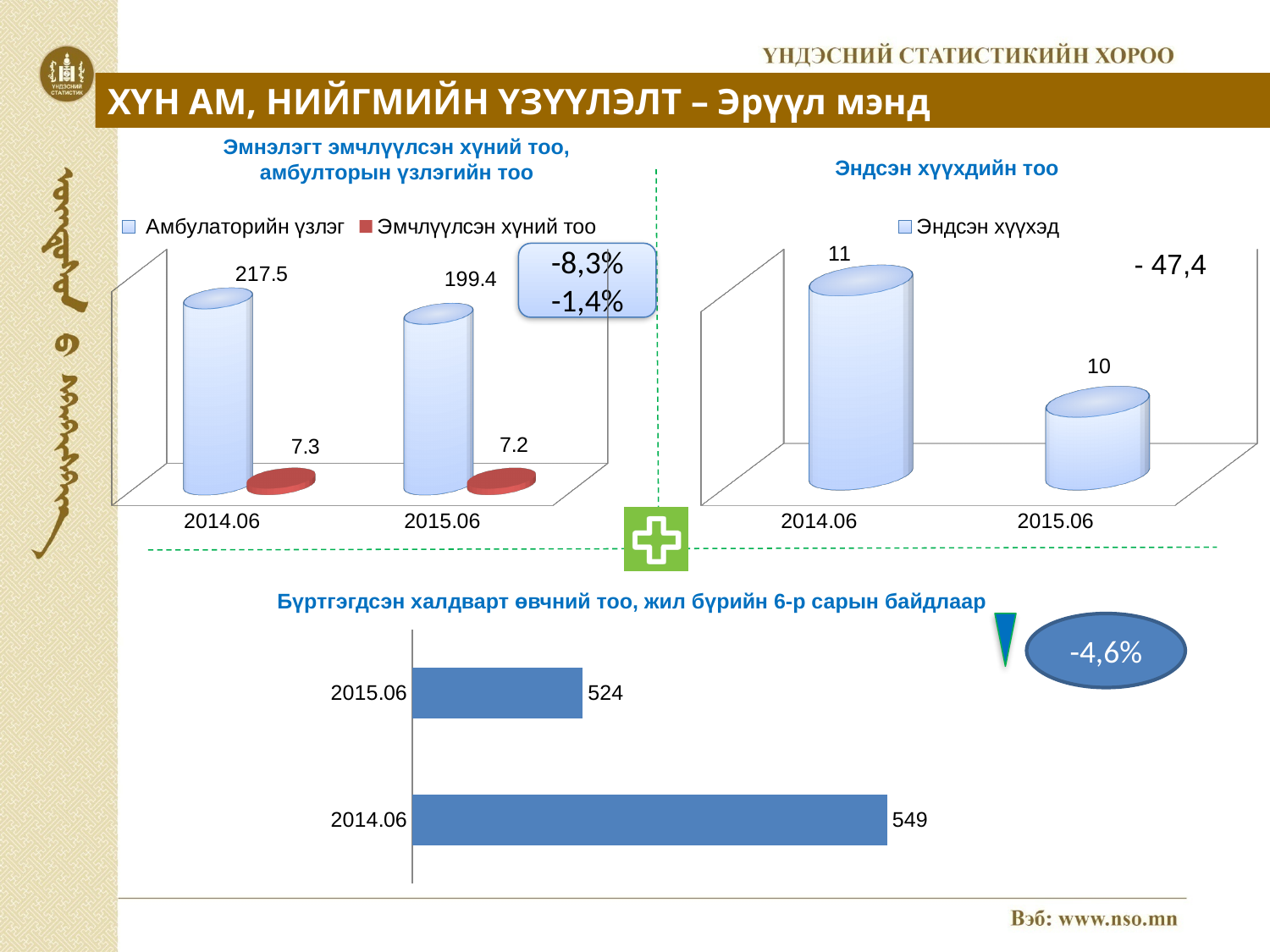
In the top-right chart 'Эндсэн хүүхдийн тоо', what is the difference between the 2014.06 and 2015.06 values? 1 In the top-right chart 'Эндсэн хүүхдийн тоо', which period has the lower value? 2015.06 How many series does the legend of the top-left chart 'Эмнэлэгт эмчлүүлсэн хүний тоо, амбулторын үзлэгийн тоо' list? 2 In the top-right chart 'Эндсэн хүүхдийн тоо', what is the value for 2014.06? 11 In the top-left chart 'Эмнэлэгт эмчлүүлсэн хүний тоо, амбулторын үзлэгийн тоо', what is the difference between the Амбулаторийн үзлэг values for 2014.06 and 2015.06? 18.1 In the top-left chart 'Эмнэлэгт эмчлүүлсэн хүний тоо, амбулторын үзлэгийн тоо', what is the value of Амбулаторийн үзлэг for 2014.06? 217.5 In the bottom chart 'Бүртгэгдсэн халдварт өвчний тоо, жил бүрийн 6-р сарын байдлаар', what is the value for 2015.06? 524 In the top-left chart 'Эмнэлэгт эмчлүүлсэн хүний тоо, амбулторын үзлэгийн тоо', what is the value of Эмчлүүлсэн хүний тоо for 2015.06? 7.2 In the top-left chart 'Эмнэлэгт эмчлүүлсэн хүний тоо, амбулторын үзлэгийн тоо', does the Амбулаторийн үзлэг series rise or fall from 2014.06 to 2015.06? fall What kind of chart is the bottom chart 'Бүртгэгдсэн халдварт өвчний тоо, жил бүрийн 6-р сарын байдлаар'? bar chart In the bottom chart 'Бүртгэгдсэн халдварт өвчний тоо, жил бүрийн 6-р сарын байдлаар', which period has the higher value? 2014.06 In the bottom chart 'Бүртгэгдсэн халдварт өвчний тоо, жил бүрийн 6-р сарын байдлаар', what is the difference between the 2014.06 and 2015.06 values? 25